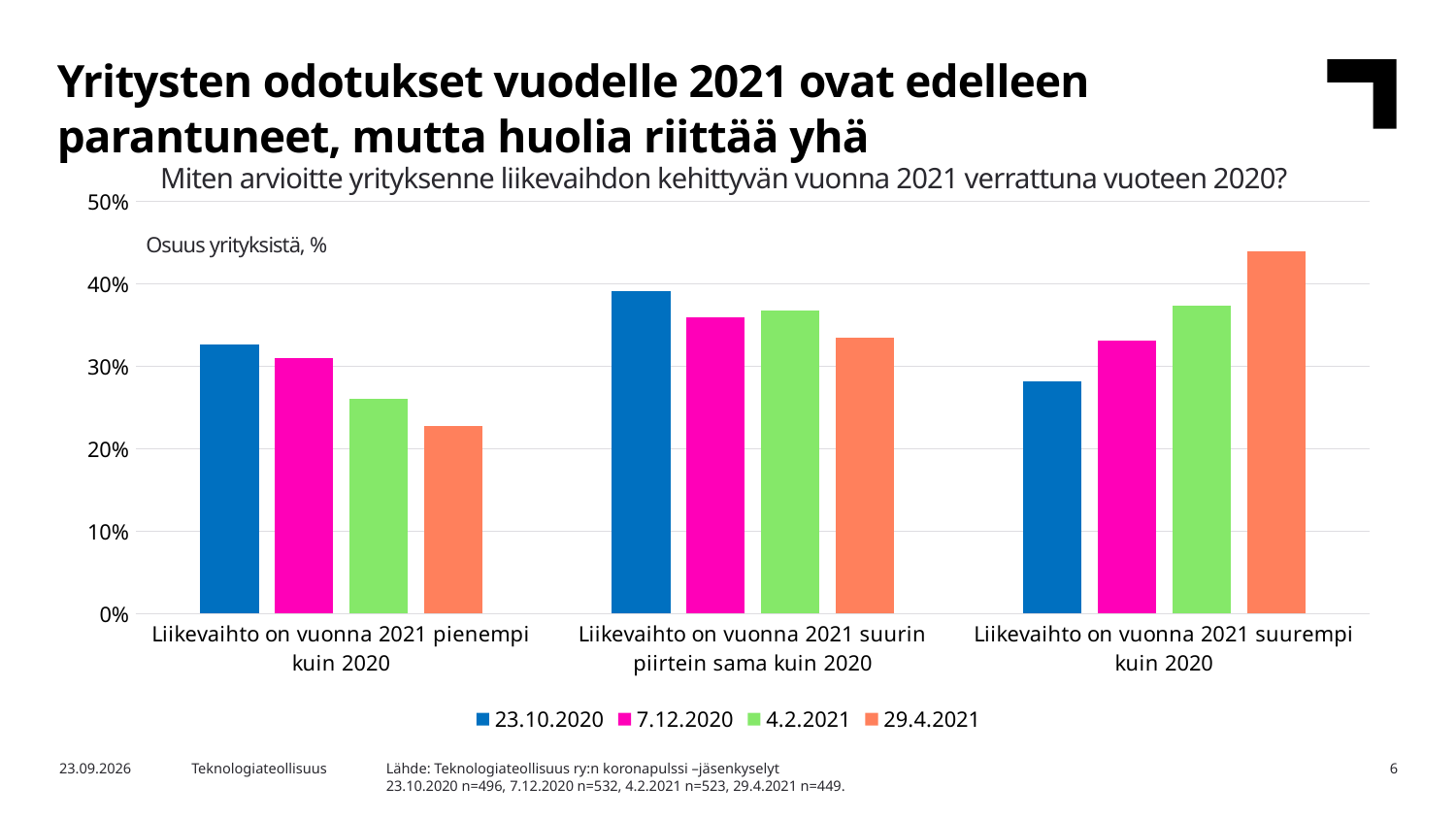
How many categories are shown on the x axis of the chart? 3 Do the values for 'Liikevaihto on vuonna 2021 pienempi kuin 2020' rise or fall from 23.10.2020 to 29.4.2021? fall Is the value for 29.4.2021 in the category 'Liikevaihto on vuonna 2021 suurempi kuin 2020' greater or less than 40%? greater Which survey date has the highest value in the category 'Liikevaihto on vuonna 2021 suurempi kuin 2020'? 29.4.2021 Is the value for 23.10.2020 in the category 'Liikevaihto on vuonna 2021 pienempi kuin 2020' greater or less than 30%? greater In the category 'Liikevaihto on vuonna 2021 suurin piirtein sama kuin 2020', which is larger: the value for 23.10.2020 or for 29.4.2021? 23.10.2020 Which survey date has the highest value in the category 'Liikevaihto on vuonna 2021 suurin piirtein sama kuin 2020'? 23.10.2020 Which survey date has the lowest value in the category 'Liikevaihto on vuonna 2021 pienempi kuin 2020'? 29.4.2021 Is the value for 29.4.2021 in the category 'Liikevaihto on vuonna 2021 pienempi kuin 2020' greater or less than 30%? less How many series does the chart legend list? 4 What is the question shown as the chart title? Miten arvioitte yrityksenne liikevaihdon kehittyvän vuonna 2021 verrattuna vuoteen 2020? What kind of chart is shown on the slide? bar chart